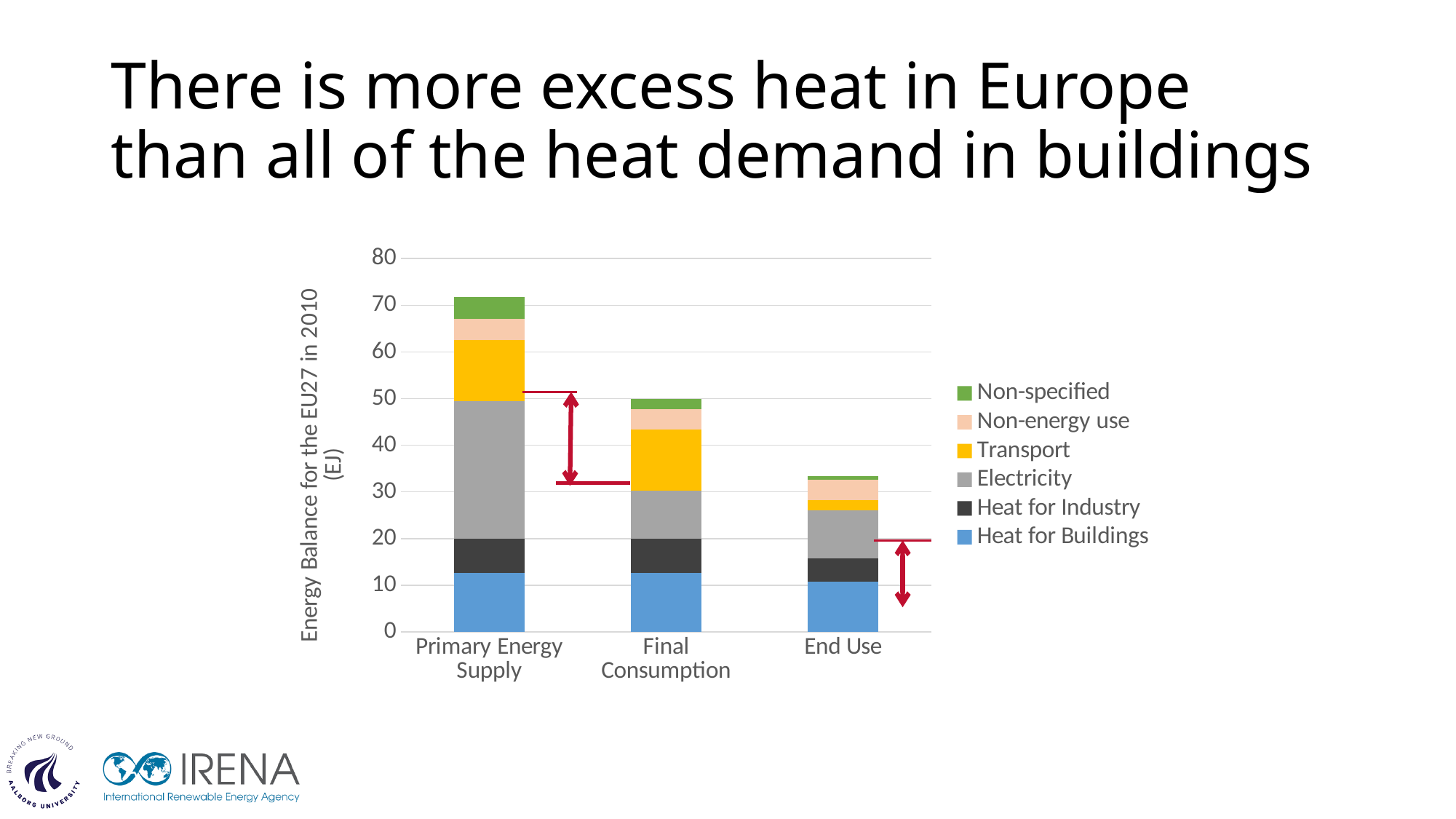
Is the total of the Final Consumption bar greater or less than 40? greater How many series does the chart's legend list? 6 Which bar is taller, Final Consumption or End Use? Final Consumption What kind of chart is shown on the slide? Stacked bar chart Which series is shown in yellow in the legend? Transport Is the total of the Primary Energy Supply bar greater or less than 60? greater Which category has the shortest stacked bar? End Use Do the bar totals rise or fall from Primary Energy Supply to End Use? Fall Is the total of the End Use bar greater or less than 40? less What is the title of the chart's vertical axis? Energy Balance for the EU27 in 2010 (EJ) How many categories are shown on the x axis of the chart? 3 Which category has the tallest stacked bar? Primary Energy Supply